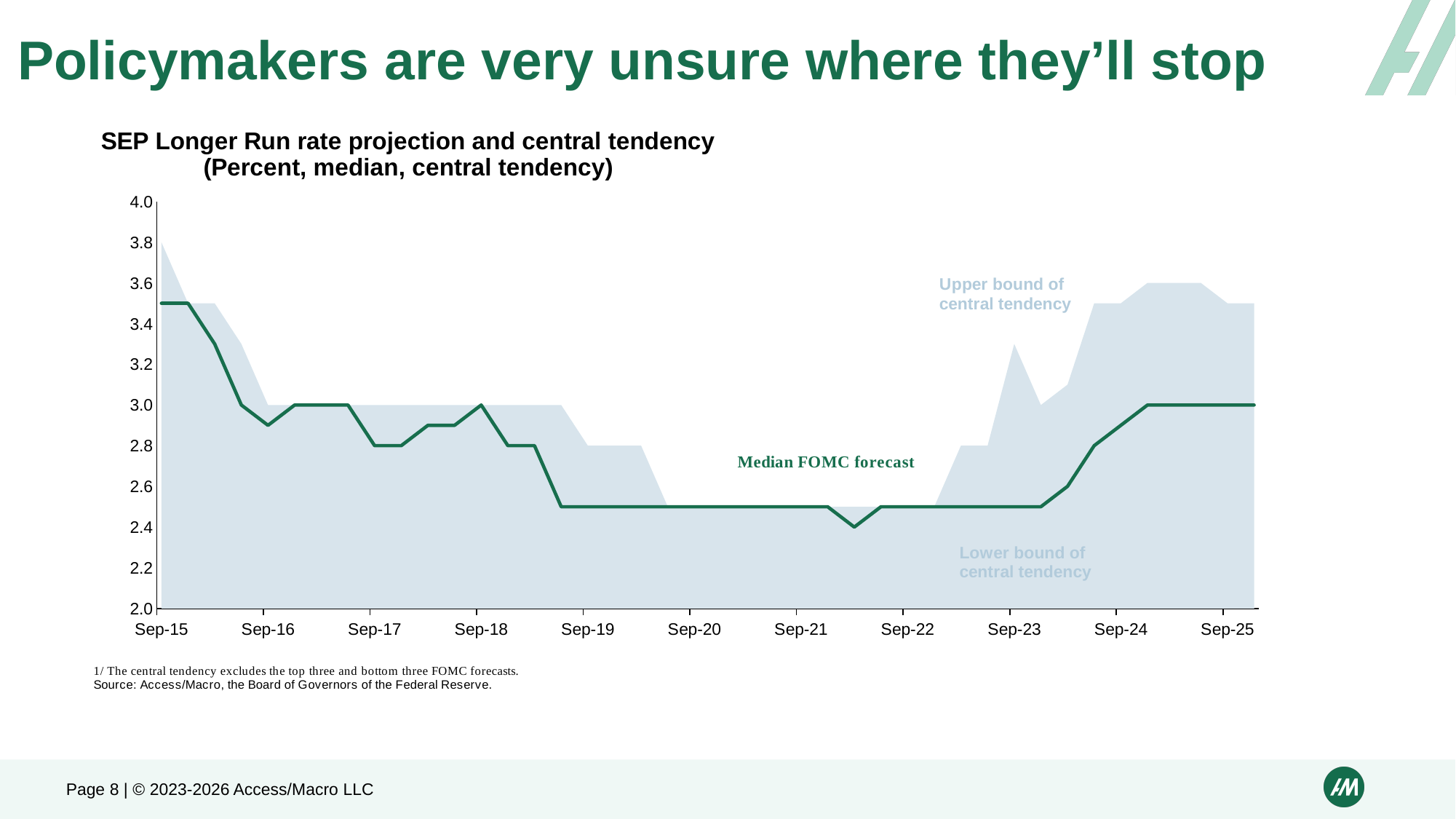
What is the value of the Median FOMC forecast at Sep-25? 3.0 What is the label of the dark green line on the chart? Median FOMC forecast Is the Median FOMC forecast at Sep-15 greater or less than 3.0? greater What is the value of the Median FOMC forecast at Sep-18? 3.0 What is the title of the chart? SEP Longer Run rate projection and central tendency Which is larger, the Median FOMC forecast at Sep-15 or at Sep-25? Sep-15 What kind of chart is shown on the slide? Combination area and line chart How many dates are labelled on the x axis? 11 Is the Median FOMC forecast at Sep-20 greater or less than 3.0? less Does the Median FOMC forecast rise or fall between Sep-23 and Sep-25? Rise Is the upper bound of the central tendency at Sep-15 greater or less than 3.6? greater